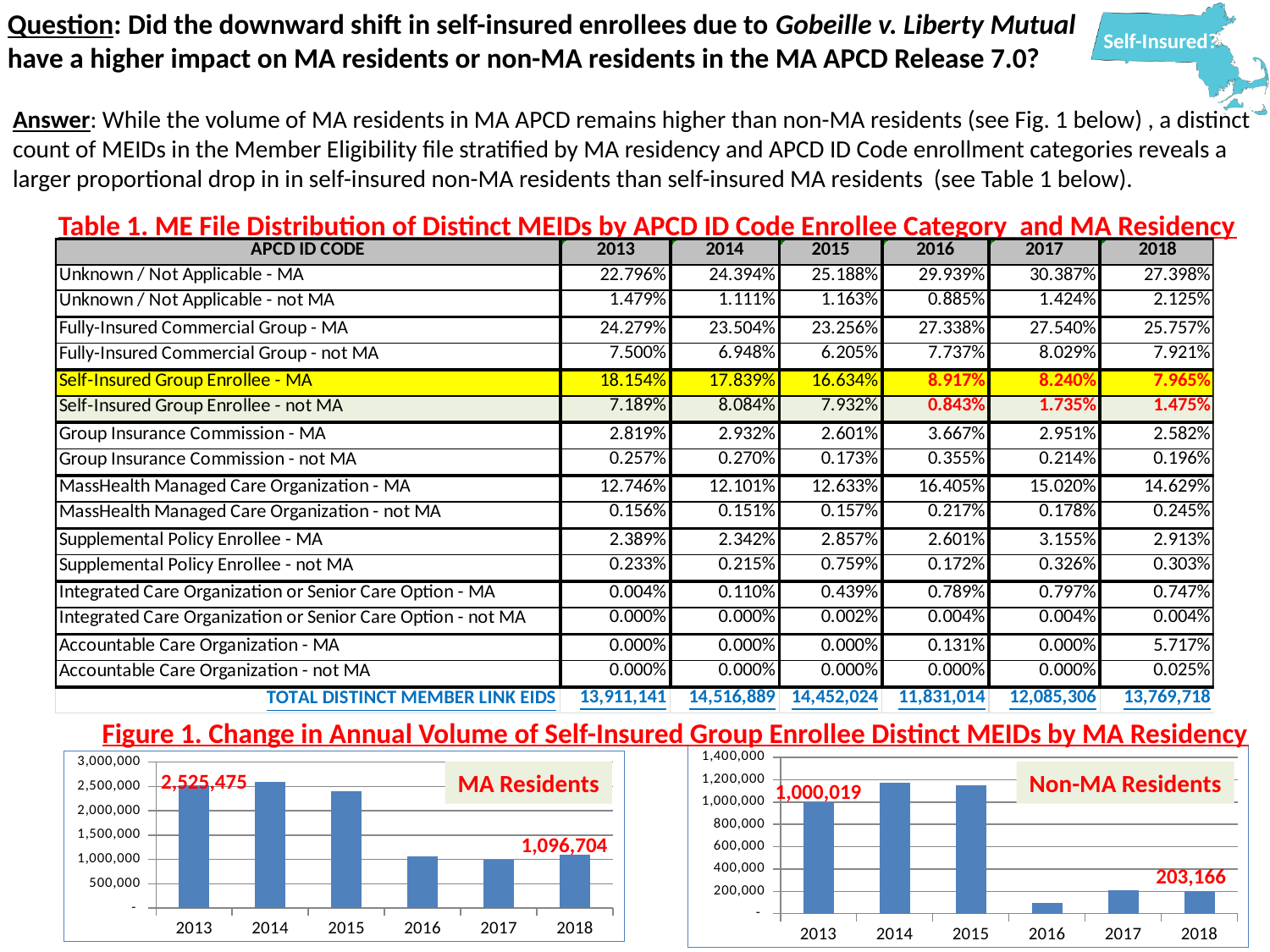
How many years are shown on the x axis of the MA Residents chart? 6 In the Non-MA Residents chart, what is the value for 2018? 203,166 In the Non-MA Residents chart, what is the difference between the 2013 and 2018 values? 796,853 In the Non-MA Residents chart, is the value for 2016 greater or less than 200,000? less In the Non-MA Residents chart, what is the value for 2013? 1,000,019 In the Non-MA Residents chart, do the values overall rise or fall from 2013 to 2018? fall In the MA Residents chart, what is the value for 2013? 2,525,475 In the Non-MA Residents chart, which year has the lowest value? 2016 In the MA Residents chart, what is the value for 2018? 1,096,704 In the MA Residents chart, what is the difference between the 2013 and 2018 values? 1,428,771 In the MA Residents chart, is the value for 2015 greater or less than 2,000,000? greater What kind of chart is the Non-MA Residents chart? bar chart